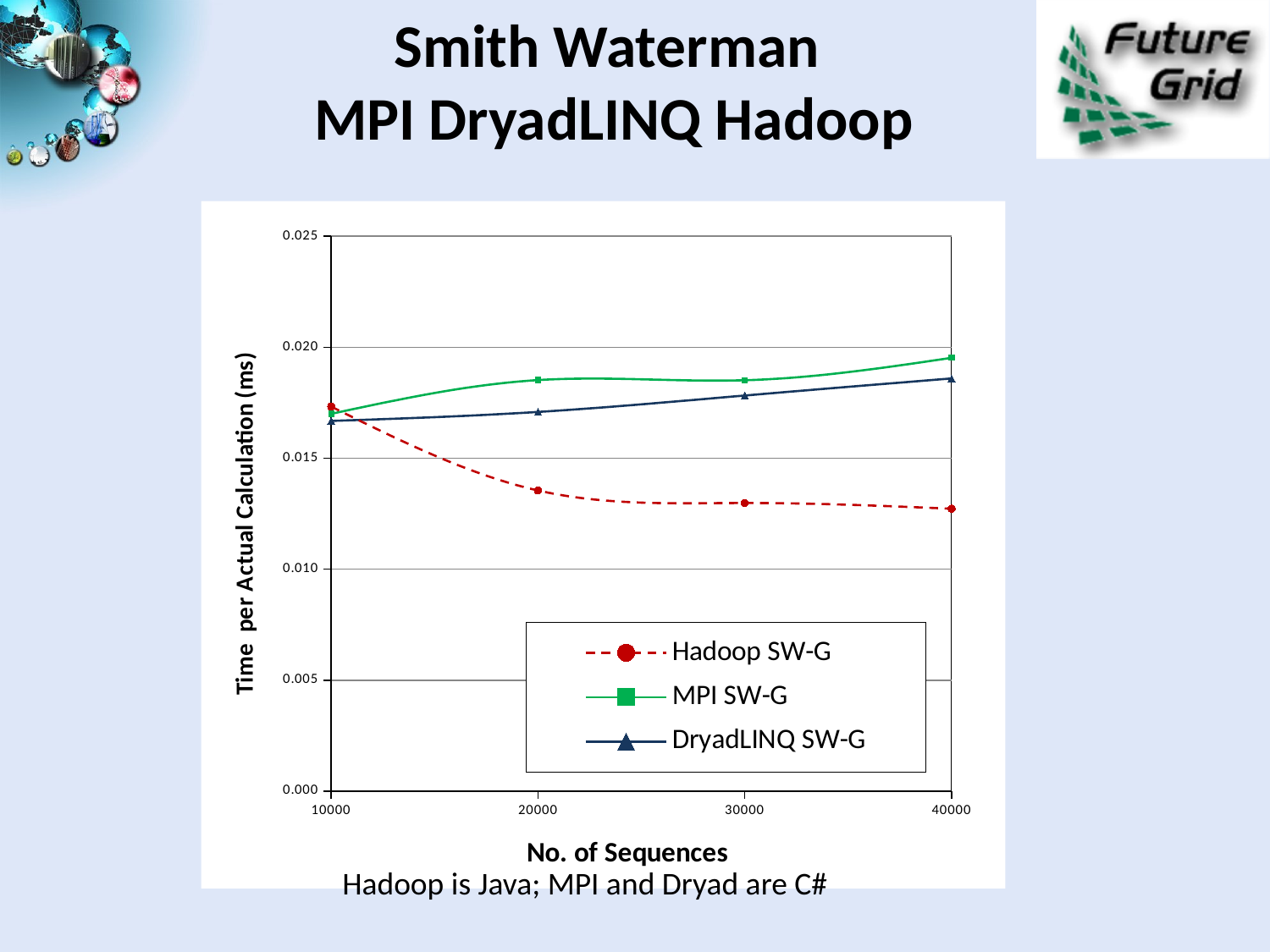
Is the value for Hadoop SW-G at 10000 sequences greater or less than 0.015? greater At 20000 sequences, which is larger: the value for Hadoop SW-G or DryadLINQ SW-G? DryadLINQ SW-G How many series does the legend list? 3 What is the title of the y axis? Time per Actual Calculation (ms) At 40000 sequences, which series has the highest time per actual calculation? MPI SW-G Does the DryadLINQ SW-G series rise or fall as the number of sequences increases from 10000 to 40000? rise Is the value for MPI SW-G at 40000 sequences greater or less than 0.015? greater What kind of chart is shown on the slide? line chart Is the value for Hadoop SW-G at 40000 sequences greater or less than 0.015? less How many data points are plotted for the Hadoop SW-G series? 4 Does the Hadoop SW-G series rise or fall as the number of sequences increases from 10000 to 40000? fall